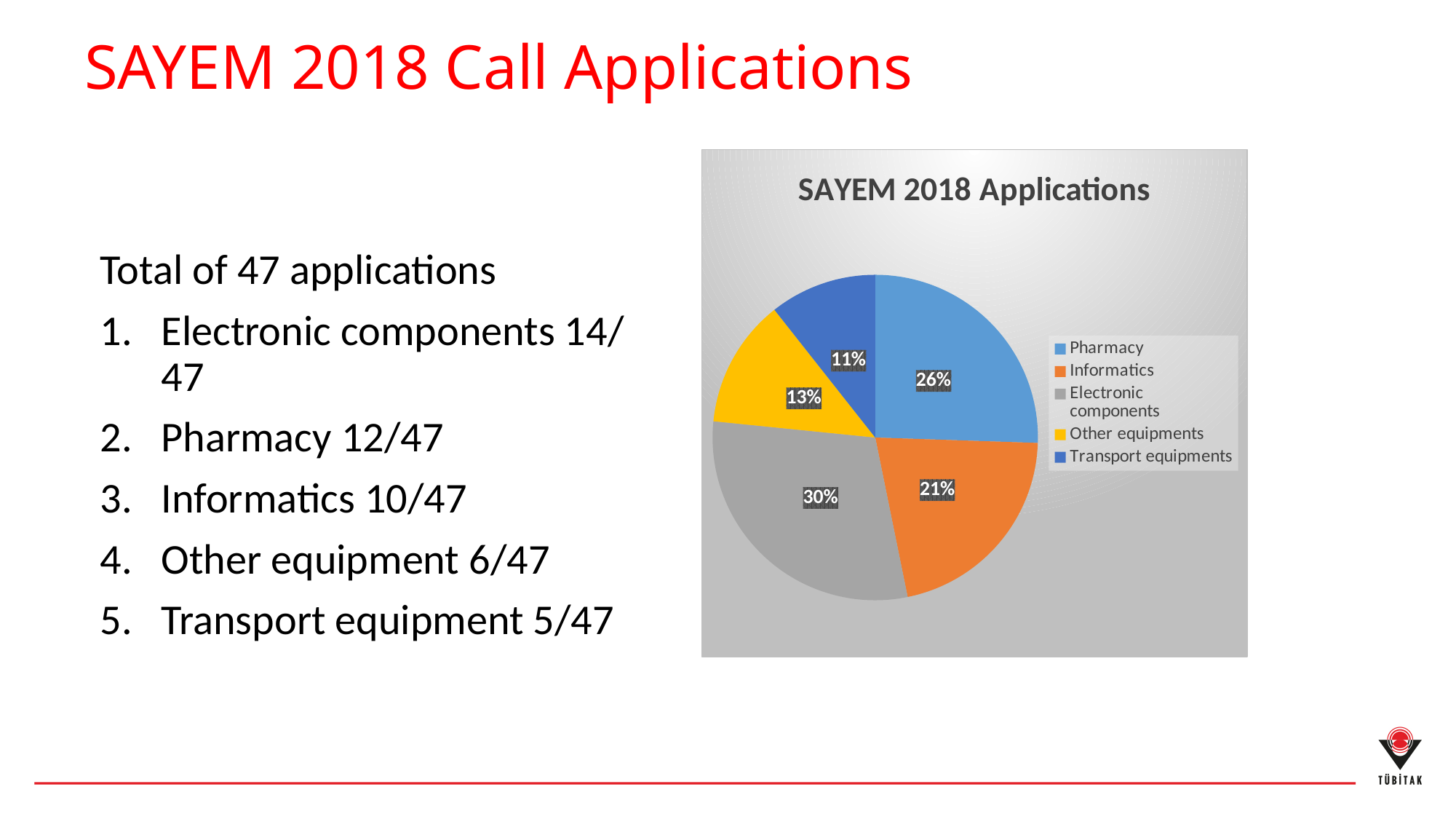
Which category has the largest slice of the pie? Electronic components Which category has the smallest slice of the pie? Transport equipments Which slice is larger, Pharmacy or Informatics? Pharmacy What is the title of the chart? SAYEM 2018 Applications What is the difference in percentage points between the Electronic components slice and the Informatics slice? 9 How many categories are shown in the pie chart? 5 What share of the pie does Transport equipments represent? 11% What kind of chart is shown on the slide? Pie chart What share of the pie does Other equipments represent? 13% What share of the pie does Electronic components represent? 30%